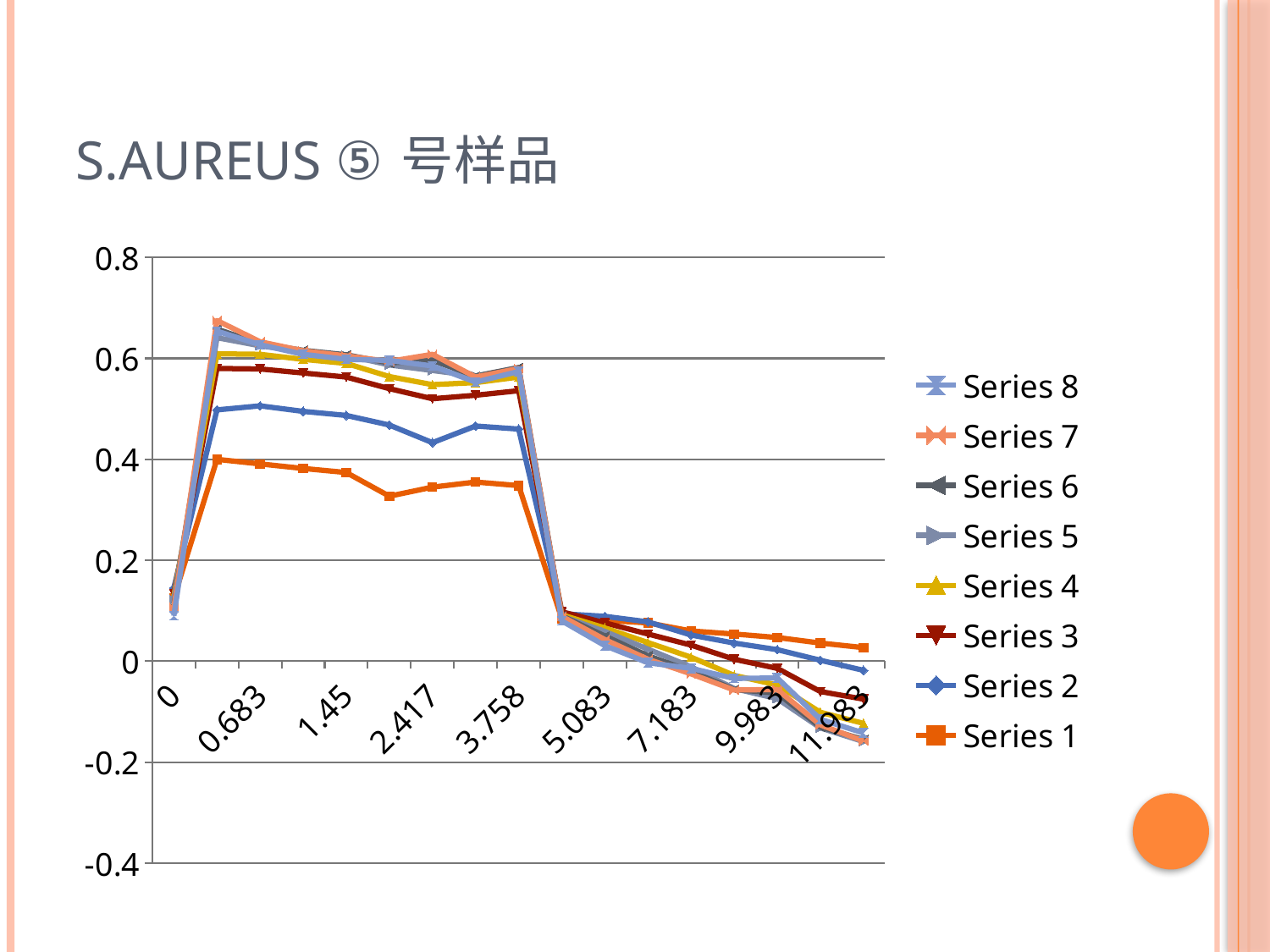
What is the title of the slide? S.AUREUS ⑤ 号样品 Is the value for Series 1 at x = 2.417 greater or less than 0.4? less Which series has the lowest value at x = 2.417? Series 1 Is the value for Series 3 at x = 0.683 greater or less than 0.6? less Is the value for Series 2 at x = 2.417 greater or less than 0.4? greater What kind of chart is shown on the slide? line chart Which series is listed first (at the top) in the legend? Series 8 How many series does the legend list? 8 Do the values of Series 1 rise or fall from x = 5.083 to x = 11.983? fall At x = 11.983, which is larger: Series 1 or Series 7? Series 1